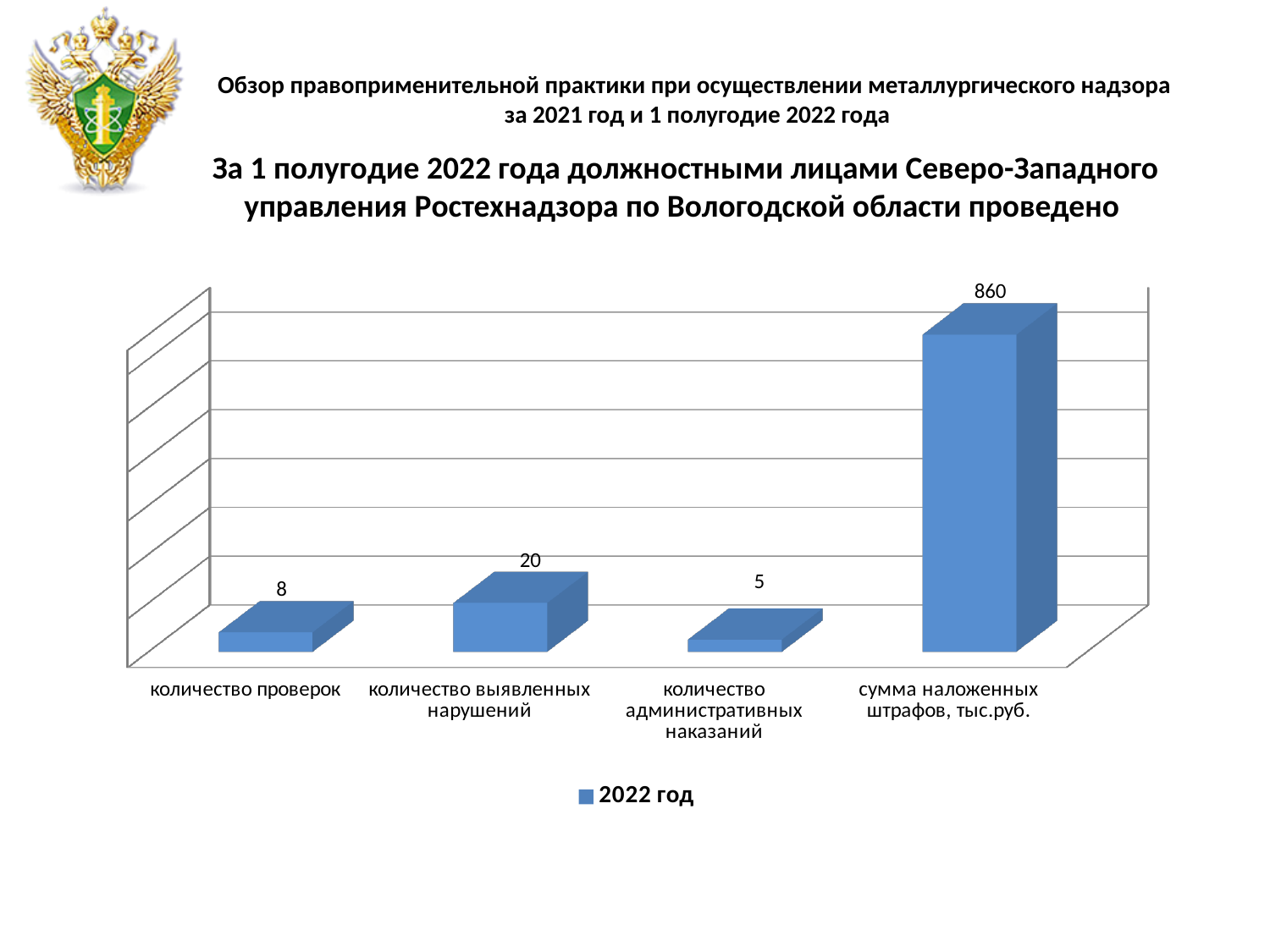
What is the value for количество административных наказаний? 5 Which is larger: количество проверок or количество административных наказаний? количество проверок How many series does the legend list? 1 What is the difference between количество выявленных нарушений and количество проверок? 12 What is the value for количество проверок? 8 Which category has the lowest value? количество административных наказаний How many categories are shown on the x axis? 4 What is the value for сумма наложенных штрафов, тыс.руб.? 860 What is the legend entry for the series? 2022 год What is the value for количество выявленных нарушений? 20 What kind of chart is shown? bar chart Which category has the highest value? сумма наложенных штрафов, тыс.руб.